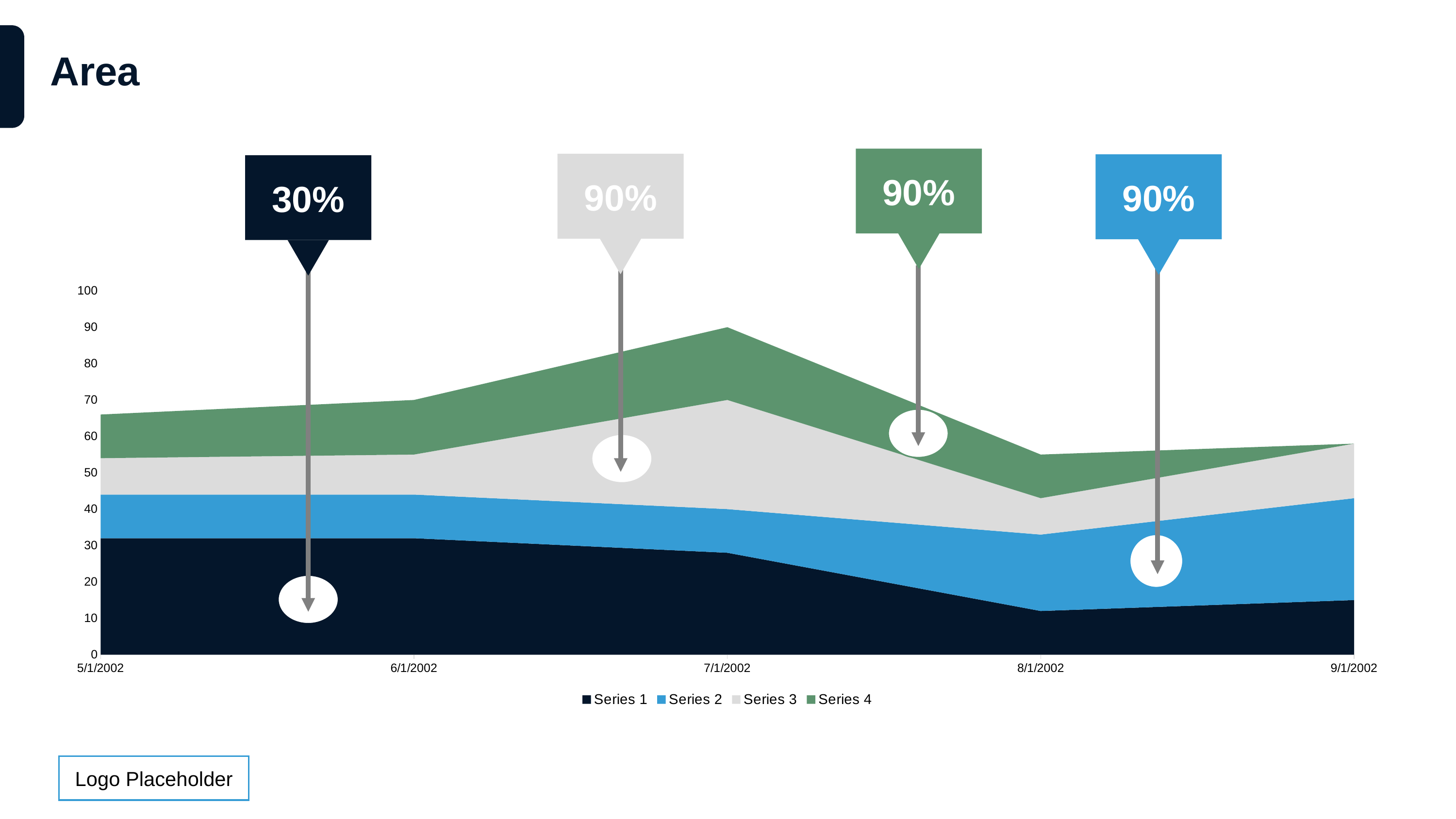
What kind of chart is shown on the slide? area chart Which is larger, the stacked total at 7/1/2002 or at 8/1/2002? 7/1/2002 At which date is the value for Series 1 lowest? 8/1/2002 How many series does the legend list? 4 Is the stacked total at 5/1/2002 greater or less than 60? greater Is the value for Series 1 at 8/1/2002 greater or less than 20? less Does the value for Series 1 rise or fall from 6/1/2002 to 8/1/2002? fall At which date does the stacked total reach its highest point? 7/1/2002 How many dates are labelled on the x axis? 5 What is the title of the slide? Area Is the value for Series 1 at 5/1/2002 greater or less than 40? less